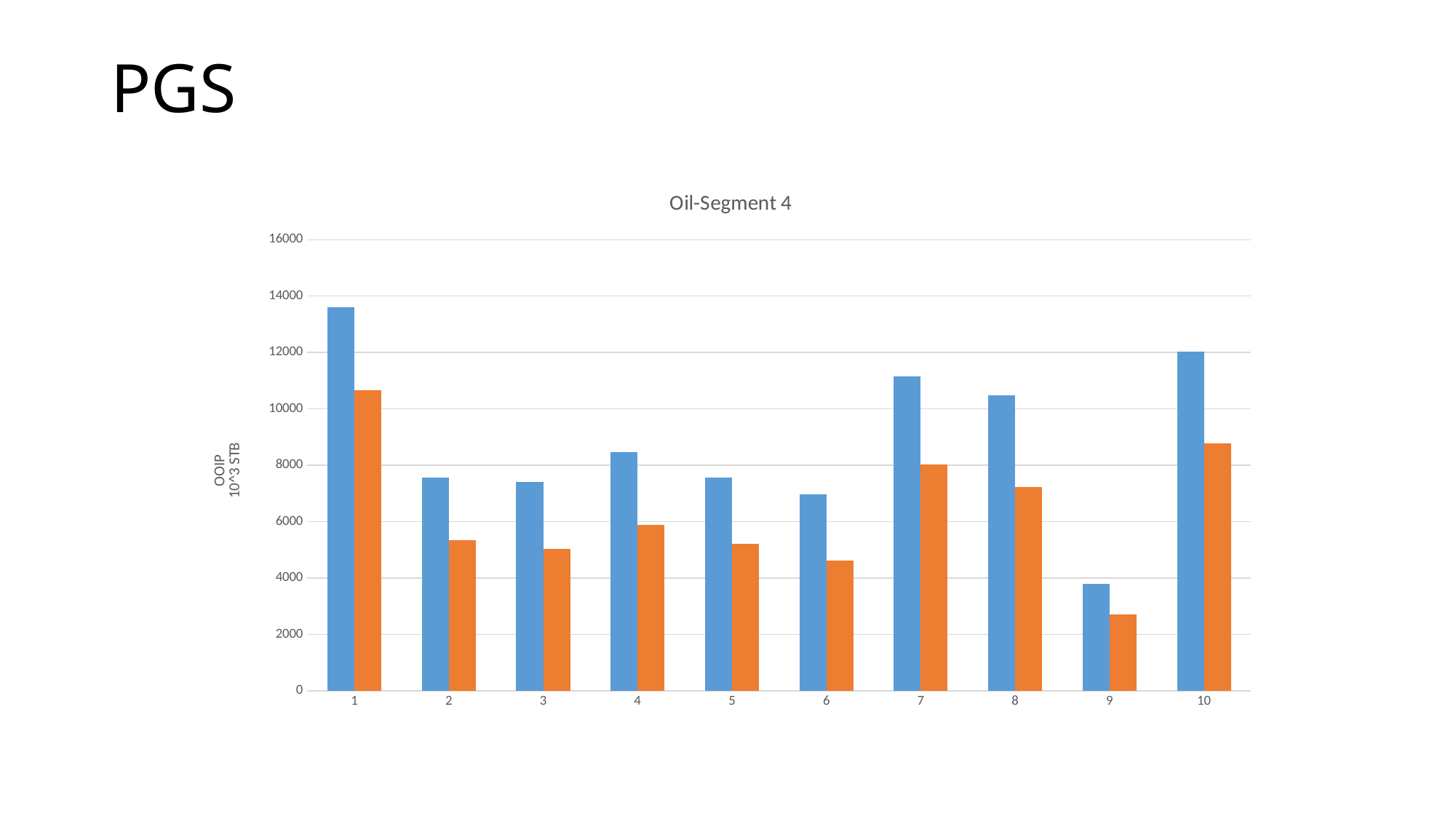
Is the blue bar for category 1 greater or less than 12000? greater Is the orange bar for category 6 greater or less than 6000? less For category 8, which bar is taller, the blue bar or the orange bar? blue Which category has the tallest blue bar? 1 How many categories are shown on the x axis of the chart? 10 Is the blue bar for category 7 greater or less than 10000? greater Which category has the tallest orange bar? 1 What is the label on the vertical axis of the chart? OOIP 10^3 STB Which category has the shortest blue bar? 9 Which category has the shortest orange bar? 9 What is the title of the chart? Oil-Segment 4 What type of chart is shown on the slide? bar chart